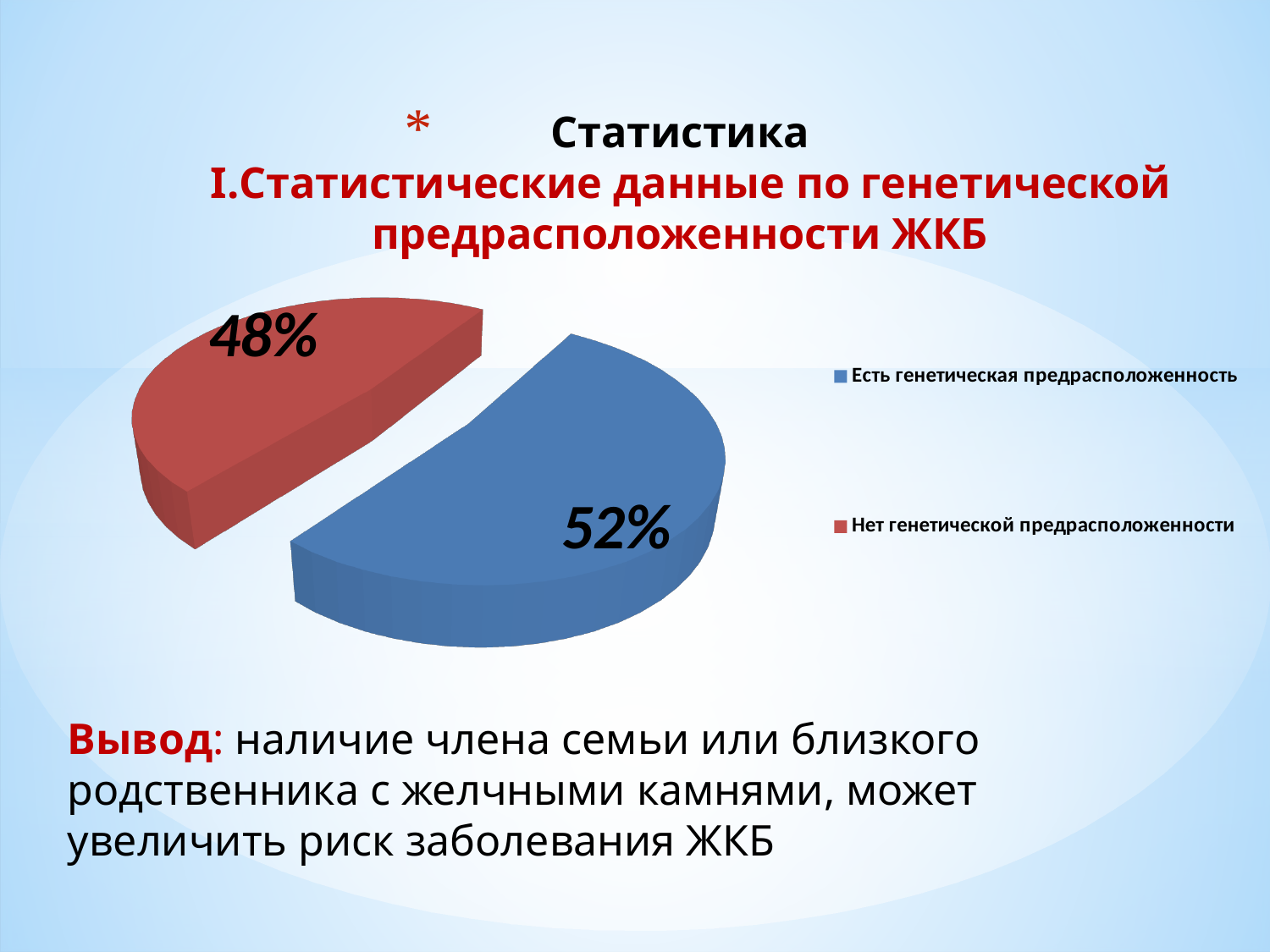
How many entries does the legend of the pie chart list? 2 Which category has the smallest slice in the pie chart? Нет генетической предрасположенности What is the value shown for the red slice of the pie chart? 48% Which category has the largest slice in the pie chart? Есть генетическая предрасположенность What share of the pie does the slice 'Есть генетическая предрасположенность' represent? 52% How many slices does the pie chart have? 2 What is the value shown for the blue slice of the pie chart? 52% What colour is the slice for 'Нет генетической предрасположенности' in the pie chart? red What is the difference in percentage points between the 'Есть генетическая предрасположенность' slice and the 'Нет генетической предрасположенности' slice? 4 What kind of chart is shown on the slide? pie chart What share of the pie does the slice 'Нет генетической предрасположенности' represent? 48% Which is larger: the share for 'Есть генетическая предрасположенность' or for 'Нет генетической предрасположенности'? Есть генетическая предрасположенность